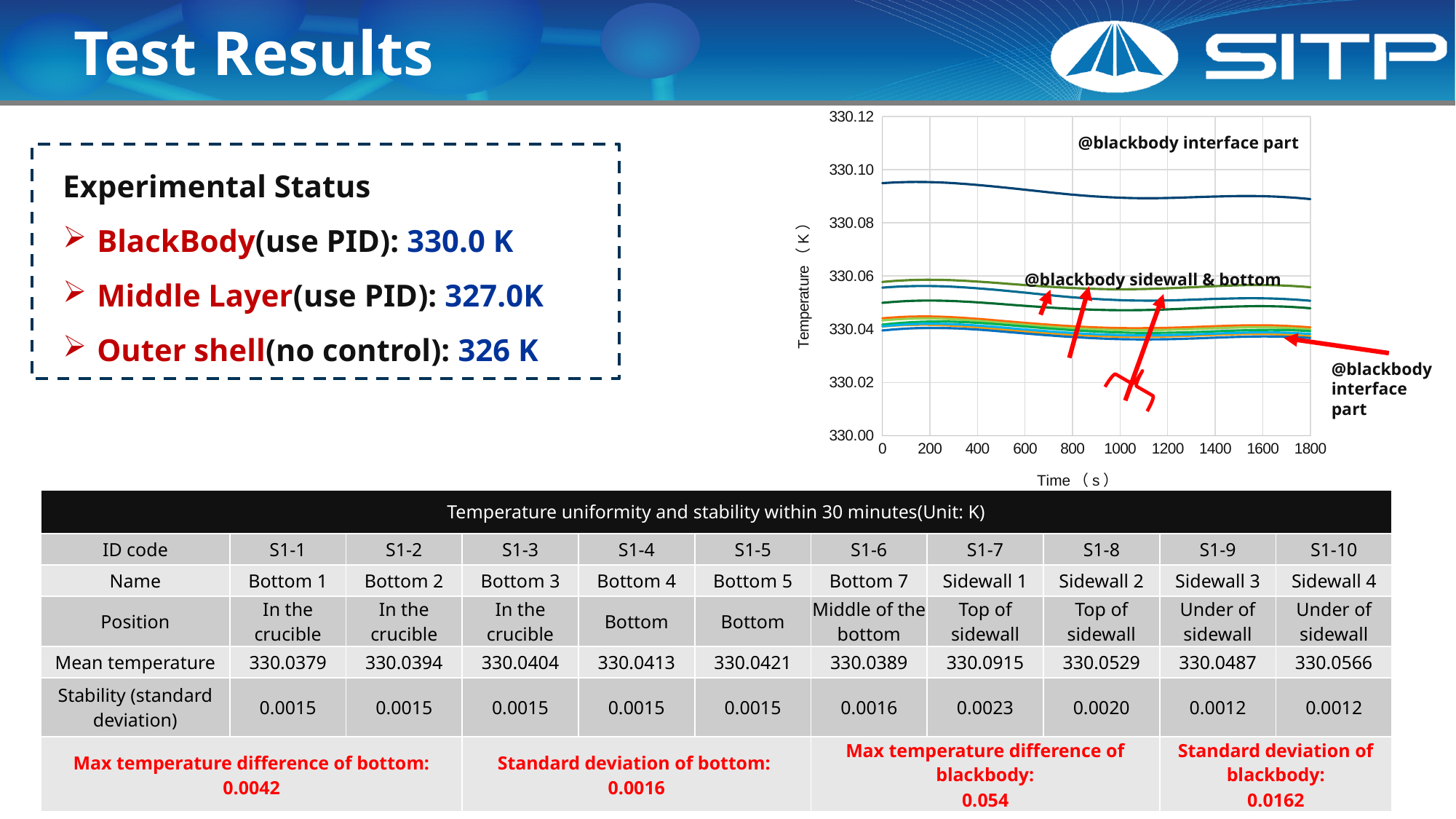
How many tick labels are shown on the x axis of the chart? 10 Is the value of the topmost line (labelled @blackbody interface part) greater or less than 330.10? less Which annotated group of lines is higher on the chart: @blackbody interface part or @blackbody sidewall & bottom? @blackbody interface part What is the highest tick value shown on the x axis of the chart? 1800 What is the label of the x axis of the chart? Time (s) Are the values of the lowest group of lines greater or less than 330.02? greater Does the topmost line rise or fall between 0 s and 800 s? fall What is the highest tick value shown on the y axis of the chart? 330.12 What is the label of the y axis of the chart? Temperature (K) Are the values of the lines labelled @blackbody sidewall & bottom greater or less than 330.08? less What kind of chart is shown on the slide? line chart